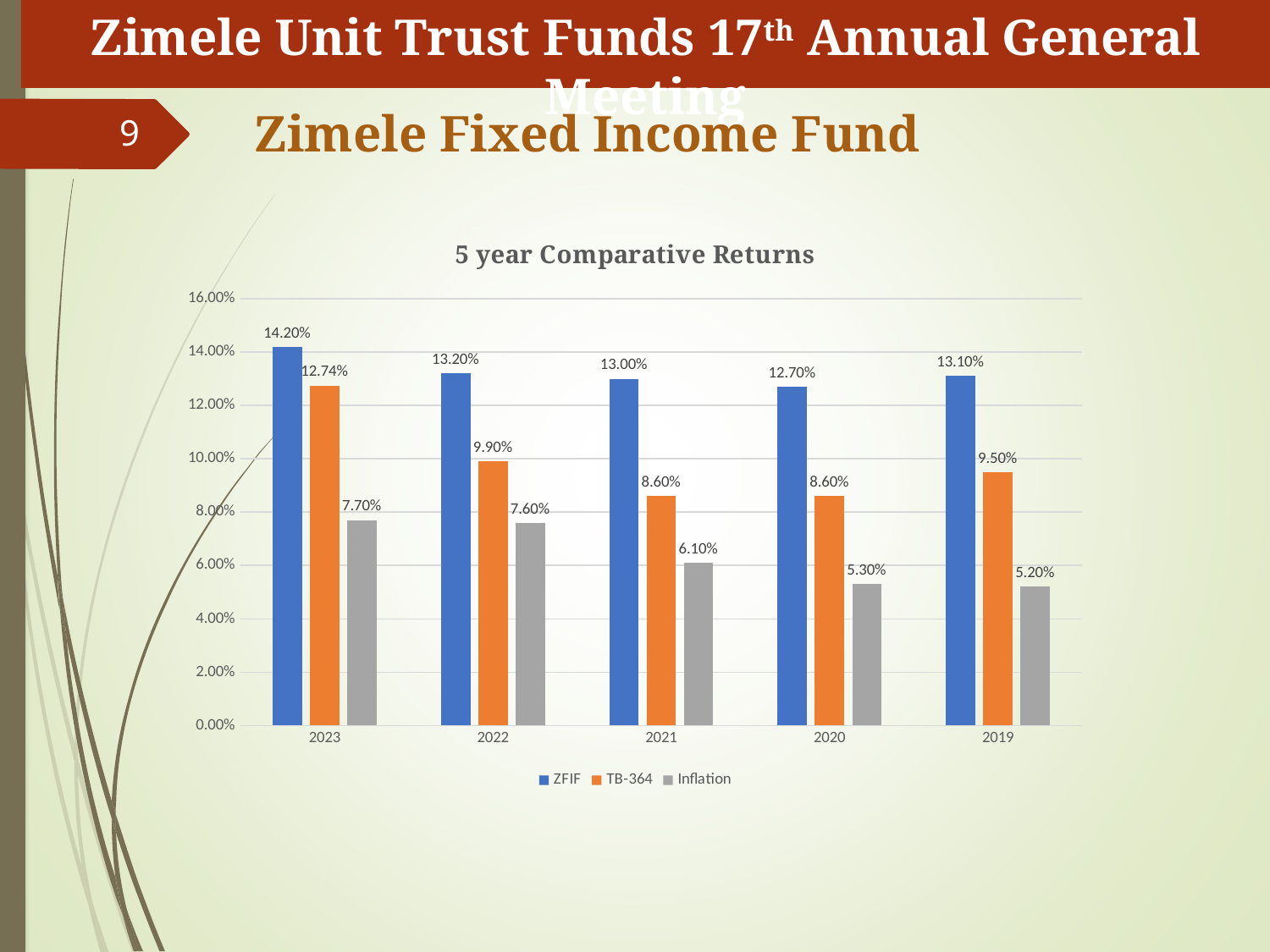
Is the ZFIF value for 2019 greater or less than 12.00%? greater What kind of chart is shown? Bar chart Which year has the highest ZFIF value? 2023 What is the ZFIF value for 2023? 14.20% What is the Inflation value for 2019? 5.20% Which is larger in 2020, the TB-364 value or the Inflation value? TB-364 What is the title of the chart? 5 year Comparative Returns What is the TB-364 value for 2022? 9.90% Which year has the lowest Inflation value? 2019 What is the difference between the ZFIF and TB-364 values in 2021? 4.40% How many series does the legend list? 3 How many years are shown on the x axis? 5